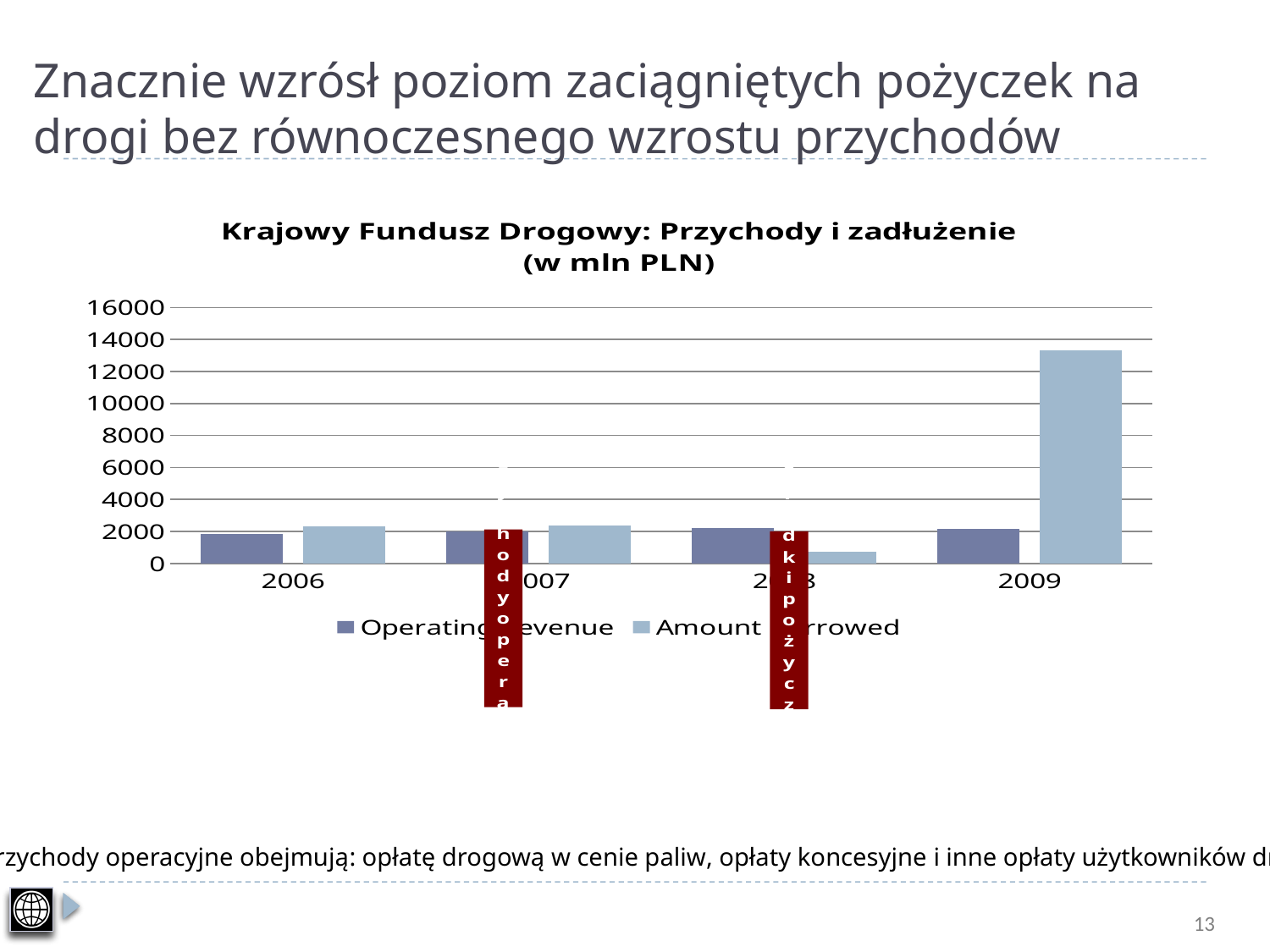
How many years are shown on the x axis of the chart? 4 Is the Amount borrowed in 2008 greater or less than 2000? less What is the title of the chart? Krajowy Fundusz Drogowy: Przychody i zadłużenie (w mln PLN) Is the Amount borrowed in 2009 greater or less than 12000? greater In 2008, which is larger: Operating revenue or Amount borrowed? Operating revenue How many series does the legend of the chart list? 2 In which year is the Amount borrowed lowest? 2008 In which year is the Amount borrowed highest? 2009 What are the two series named in the chart legend? Operating revenue and Amount borrowed What kind of chart is shown on the slide? bar chart In 2009, which is larger: Operating revenue or Amount borrowed? Amount borrowed